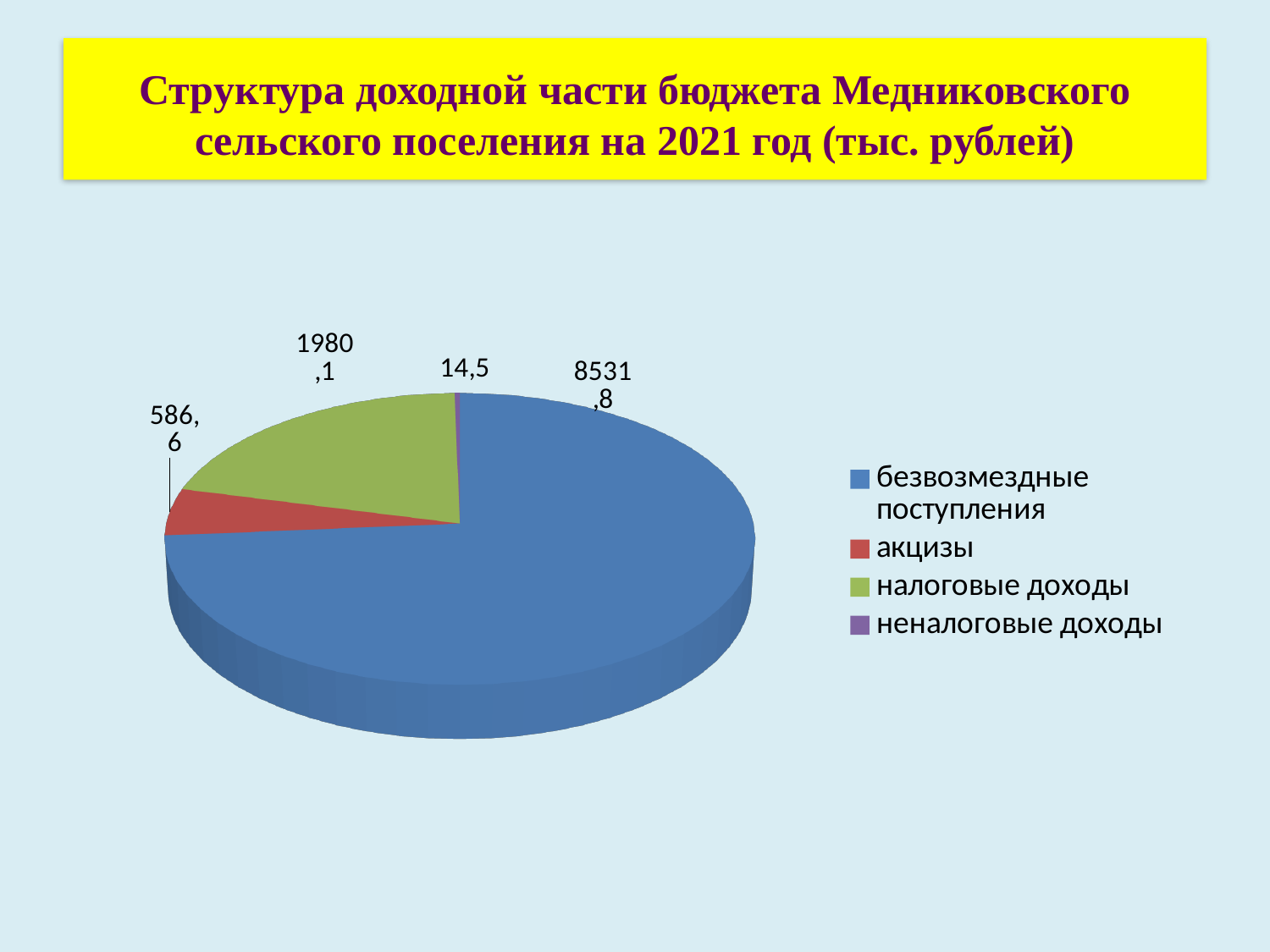
What is the value for акцизы? 586,6 What colour is the slice for акцизы? Red What is the value for налоговые доходы? 1980,1 What is the difference between безвозмездные поступления and налоговые доходы? 6551,7 What kind of chart is shown on the slide? Pie chart Which category has the smallest slice of the pie? неналоговые доходы What is the difference between налоговые доходы and акцизы? 1393,5 What is the value for безвозмездные поступления? 8531,8 Which category has the largest slice of the pie? безвозмездные поступления What is the value for неналоговые доходы? 14,5 Which is larger, акцизы or налоговые доходы? налоговые доходы How many categories does the legend list? 4